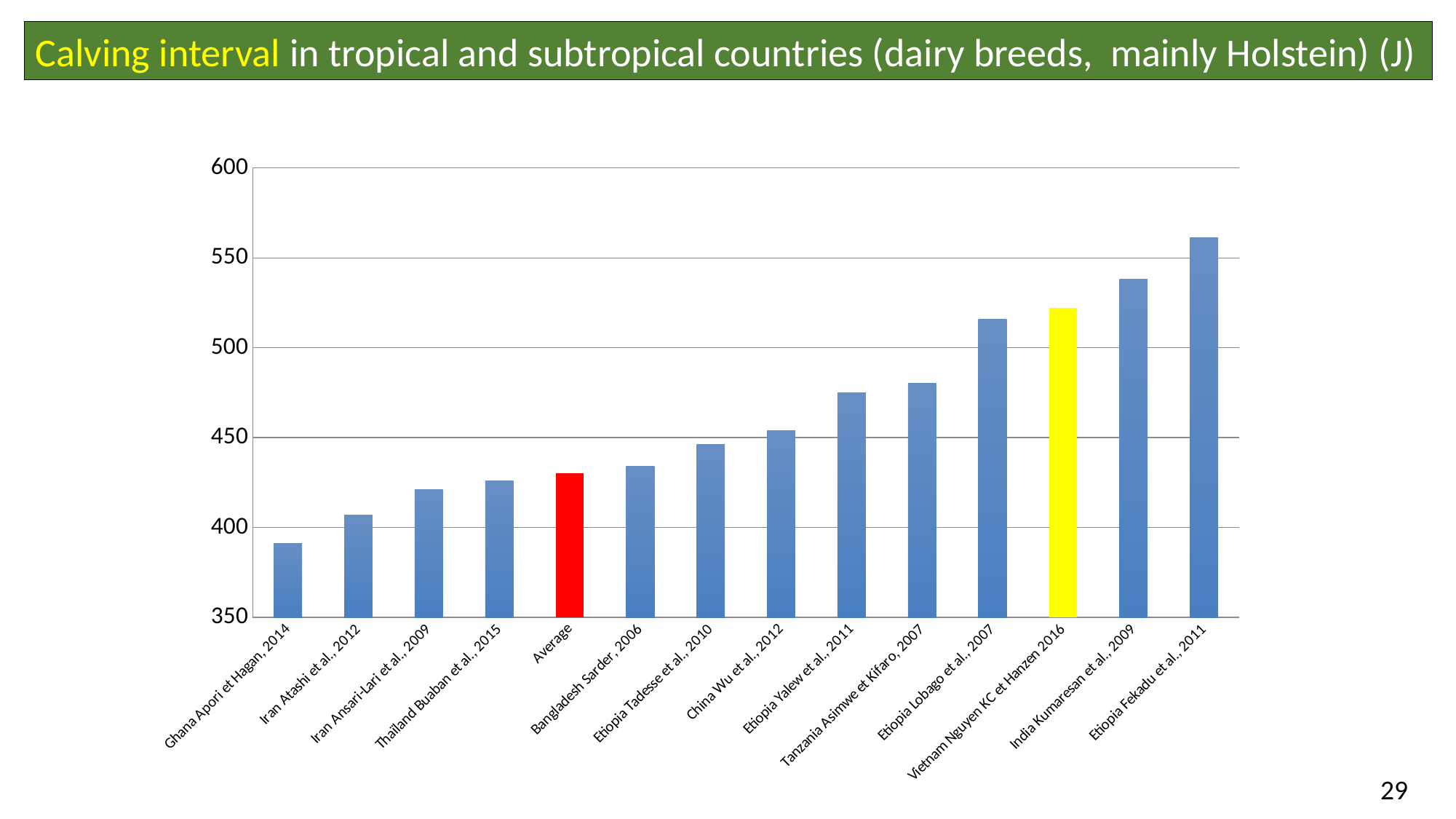
What kind of chart is shown on the slide? Bar chart Is the value for Ghana Apori et Hagan, 2014 greater or less than 400? less Is the value for Vietnam Nguyen KC et Hanzen 2016 greater or less than 500? greater Is the value for Etiopia Fekadu et al., 2011 greater or less than 550? greater Do the bar values rise or fall from left to right along the x axis? Rise How many bars (categories) are plotted in the chart? 14 Which category has the highest calving interval in the chart? Etiopia Fekadu et al., 2011 Which is larger, the value for India Kumaresan et al., 2009 or the value for Bangladesh Sarder, 2006? India Kumaresan et al., 2009 Which category has the lowest calving interval in the chart? Ghana Apori et Hagan, 2014 What colour is the bar for Average? Red